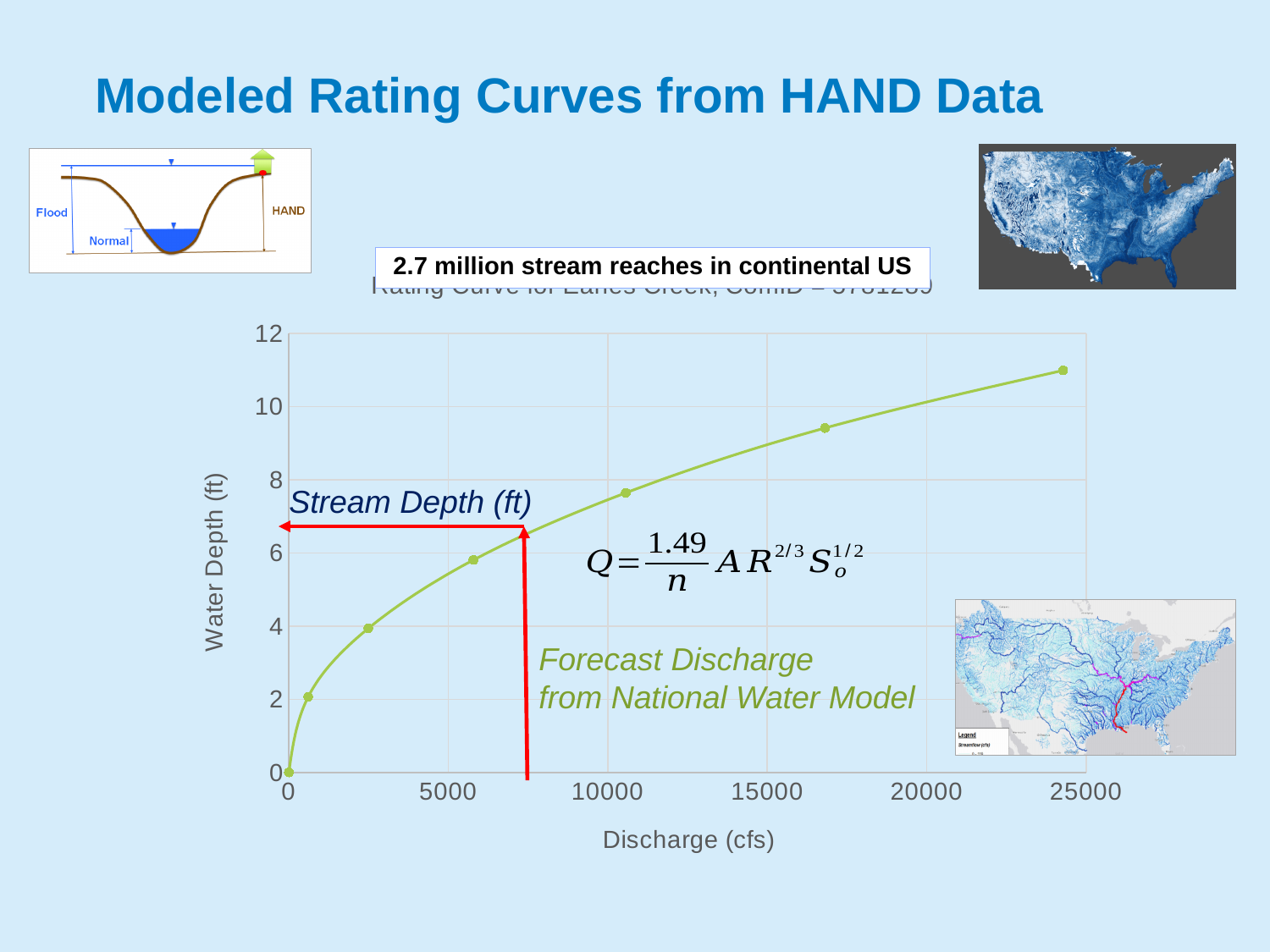
What is the label of the y axis of the chart? Water Depth (ft) Which is larger, the water depth at the data point near 17000 cfs or at the data point near 10000 cfs? near 17000 cfs Is the water depth at the data point near 10000 cfs greater or less than 6? greater What is the highest value shown on the x axis? 25000 How many data points are marked on the curve? 7 Is the water depth at the data point near 10000 cfs greater or less than 8? less Does water depth rise or fall as discharge increases along the x axis? rise What is the highest value shown on the y axis? 12 What kind of chart is shown on the slide? line chart What is the label of the x axis of the chart? Discharge (cfs) Is the water depth at the rightmost data point greater or less than 10? greater